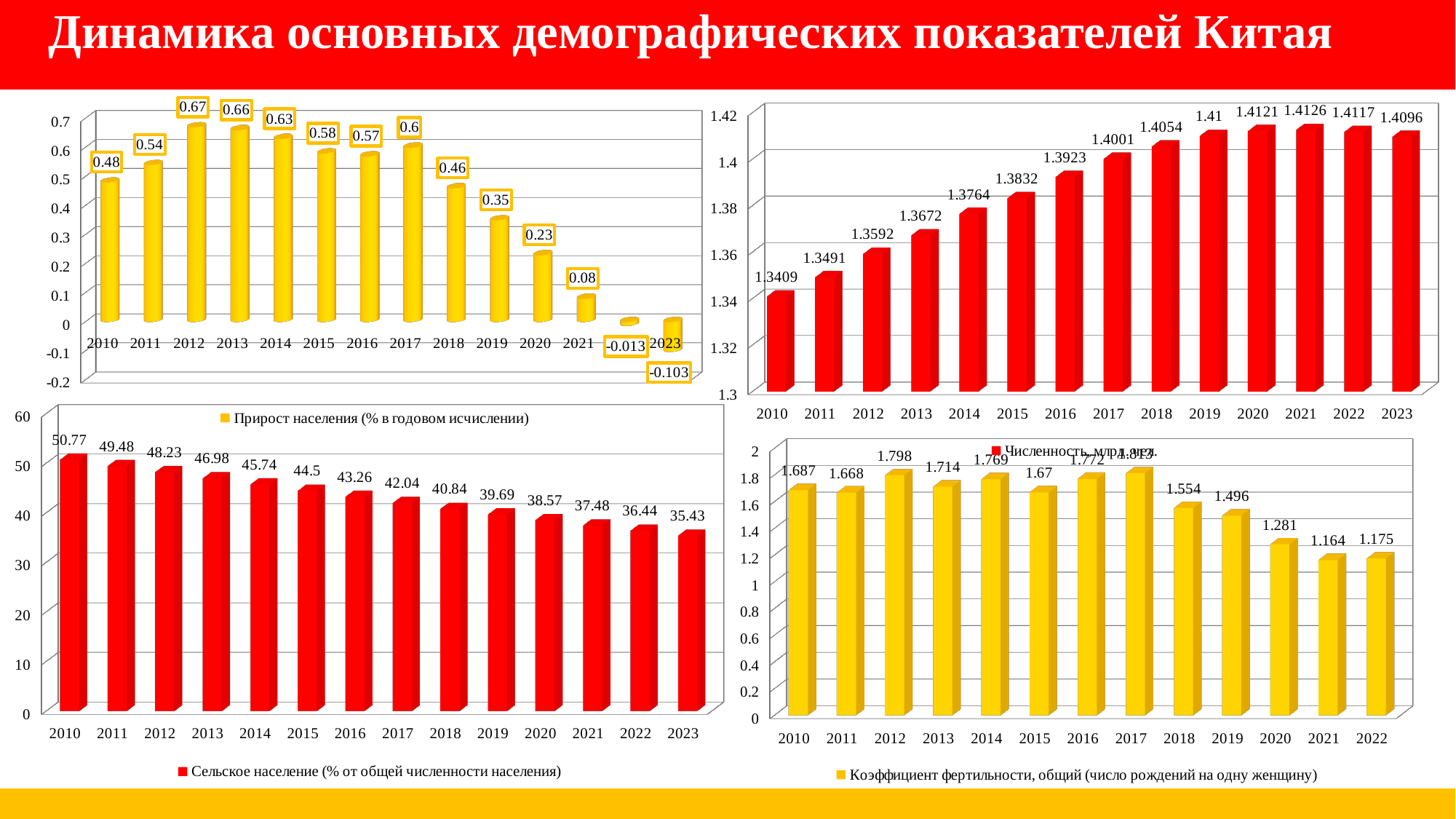
On the top-left chart (Прирост населения), what is the value for 2012? 0.67 What kind of chart is the bottom-right chart (Коэффициент фертильности)? bar chart On the bottom-right chart (Коэффициент фертильности), which is larger, the value for 2012 or the value for 2014? 2012 On the bottom-left chart (Сельское население), what is the value for 2015? 44.5 On the top-right chart (Численность, млрд чел.), what is the difference between the 2023 value and the 2010 value? 0.0687 On the bottom-right chart (Коэффициент фертильности), what is the value for 2020? 1.281 On the top-left chart (Прирост населения), which year has the highest value? 2012 On the bottom-left chart (Сельское население), how many years are shown? 14 On the bottom-left chart (Сельское население), do the values rise or fall from 2010 to 2023? fall On the top-right chart (Численность, млрд чел.), what is the value for 2021? 1.4126 On the top-left chart (Прирост населения), what is the value for 2023? -0.103 On the top-right chart (Численность, млрд чел.), which year has the lowest value? 2010